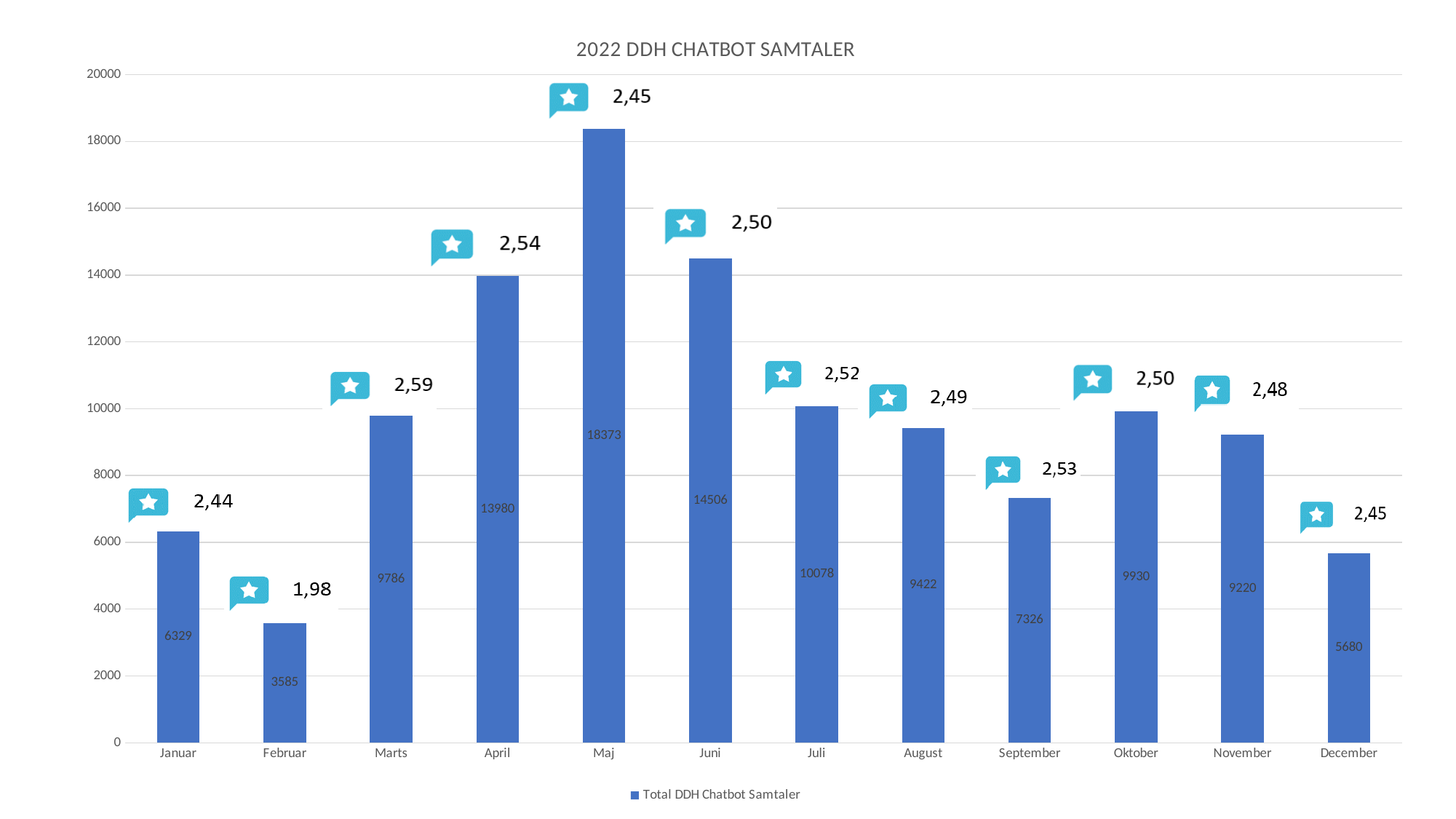
What is the value for Februar? 3585 What is the title of the chart? 2022 DDH CHATBOT SAMTALER What is the value for Oktober? 9930 Is the value for April greater or less than 12000? greater Which is larger, the value for Marts or the value for November? Marts What is the difference between the values for Maj and Juni? 3867 Which month has the lowest value? Februar Which month has the highest value? Maj How many series does the legend list? 1 What kind of chart is this? Bar chart What is the value for Maj? 18373 How many months are shown on the x axis? 12